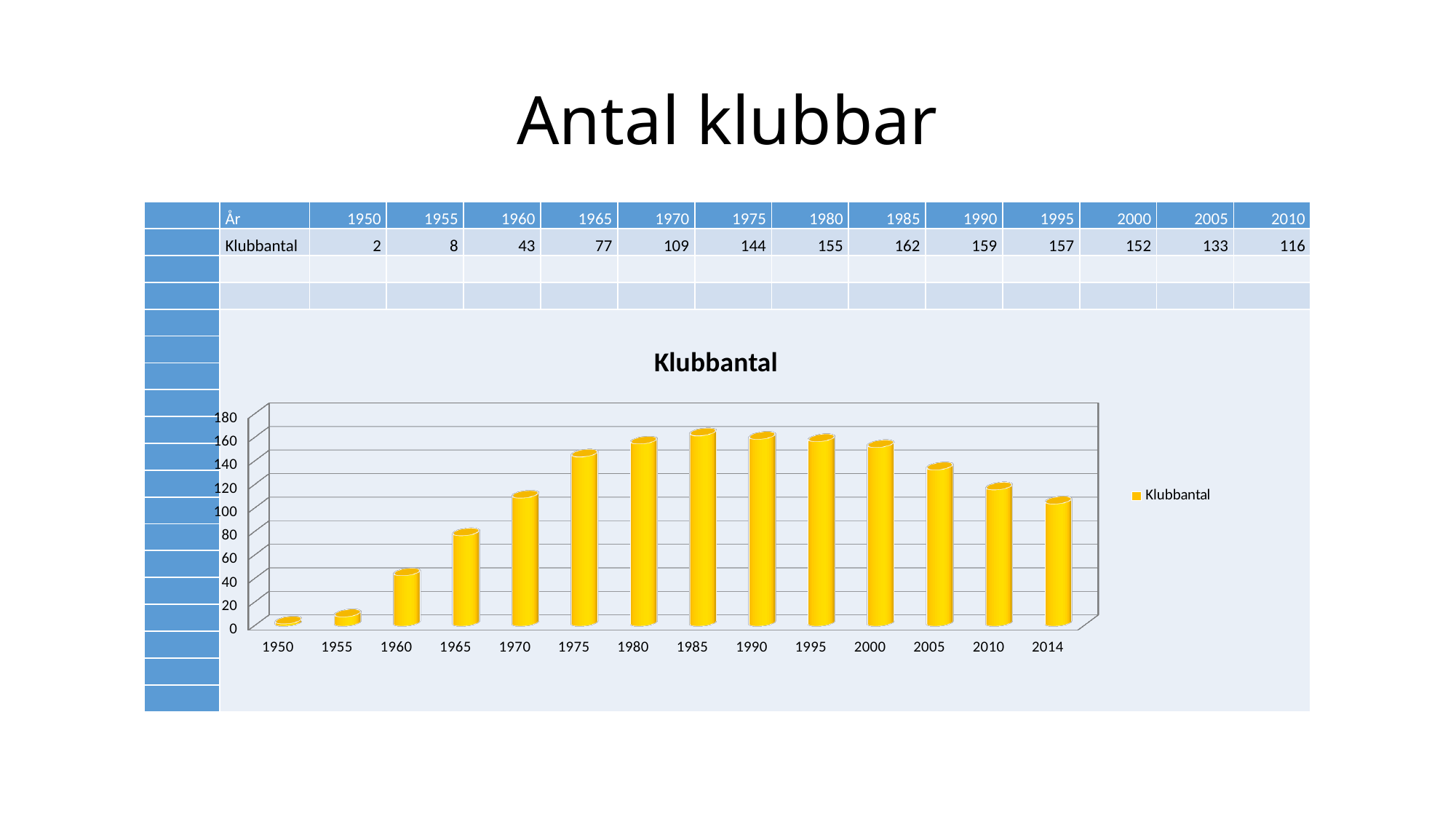
Which is larger, the Klubbantal value for 1975 or for 2005? 1975 What is the difference between the Klubbantal values for 1985 and 2010? 46 What is the Klubbantal value for 1960? 43 Which year has the lowest Klubbantal? 1950 What is the title of the chart? Klubbantal What is the Klubbantal value for 1985? 162 How many series does the legend list? 1 Which year has the highest Klubbantal? 1985 Is the Klubbantal value for 2014 greater or less than 120? less Do the Klubbantal values rise or fall from 1985 to 2014? fall What kind of chart is shown on the slide? bar chart How many bars does the chart have? 14